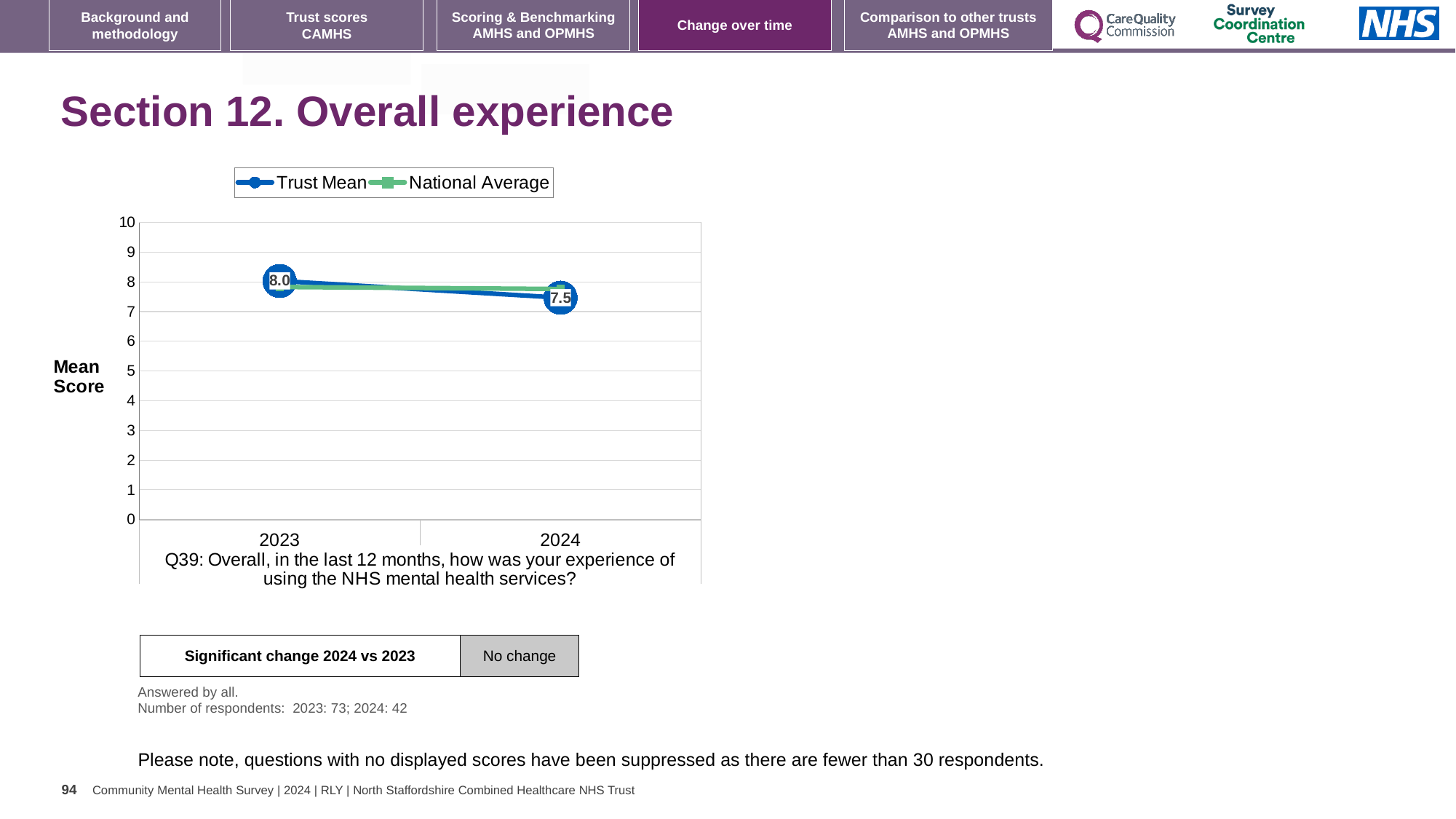
Does the Trust Mean score rise or fall from 2023 to 2024? Fall What is the difference between the Trust Mean score in 2023 and in 2024? 0.5 How many years are plotted on the x axis of the chart? 2 In which year is the Trust Mean score lowest? 2024 Is the National Average value for 2023 greater or less than 7? greater What kind of chart is shown on the slide? Line chart What is the Trust Mean score for 2024? 7.5 In which year is the Trust Mean score highest? 2023 Which is larger, the Trust Mean score for 2023 or for 2024? 2023 Is the National Average value for 2024 greater or less than 9? less What is the Trust Mean score for 2023? 8.0 How many series does the chart legend list? 2